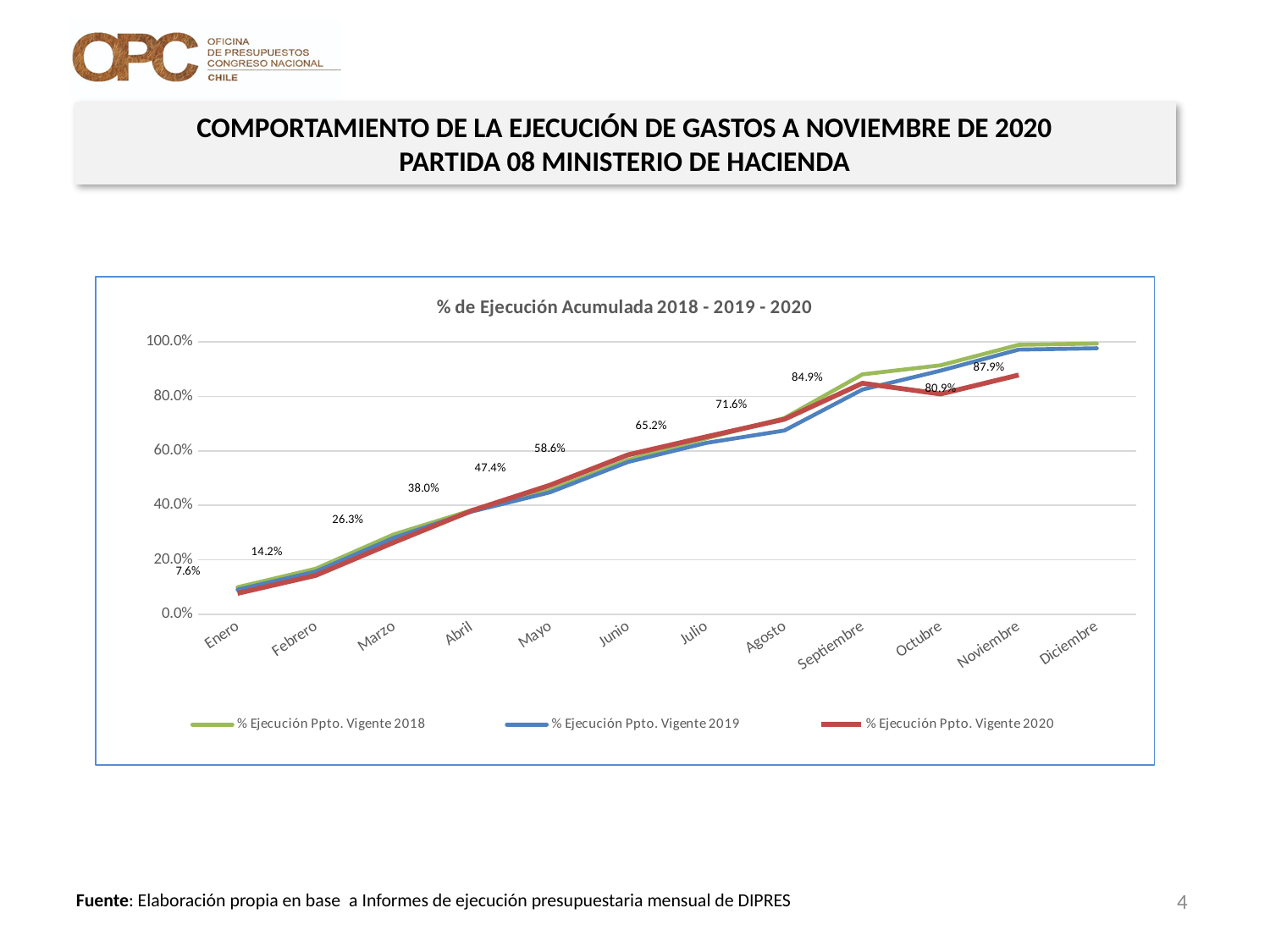
What is the difference between the % Ejecución Ppto. Vigente 2020 values for Septiembre and Octubre? 4.0% What is the value for % Ejecución Ppto. Vigente 2020 in Noviembre? 87.9% How many series does the legend list? 3 What is the value for % Ejecución Ppto. Vigente 2020 in Octubre? 80.9% Which is larger for % Ejecución Ppto. Vigente 2020: Agosto or Septiembre? Septiembre What is the value for % Ejecución Ppto. Vigente 2020 in Enero? 7.6% What is the value for % Ejecución Ppto. Vigente 2020 in Junio? 58.6% What type of chart is shown on the slide? line chart What is the title of the chart? % de Ejecución Acumulada 2018 - 2019 - 2020 Is the value for % Ejecución Ppto. Vigente 2018 in Diciembre greater or less than 80.0%? greater How many months are shown on the x axis? 12 Does the % Ejecución Ppto. Vigente 2019 line generally rise or fall from Enero to Diciembre? rise